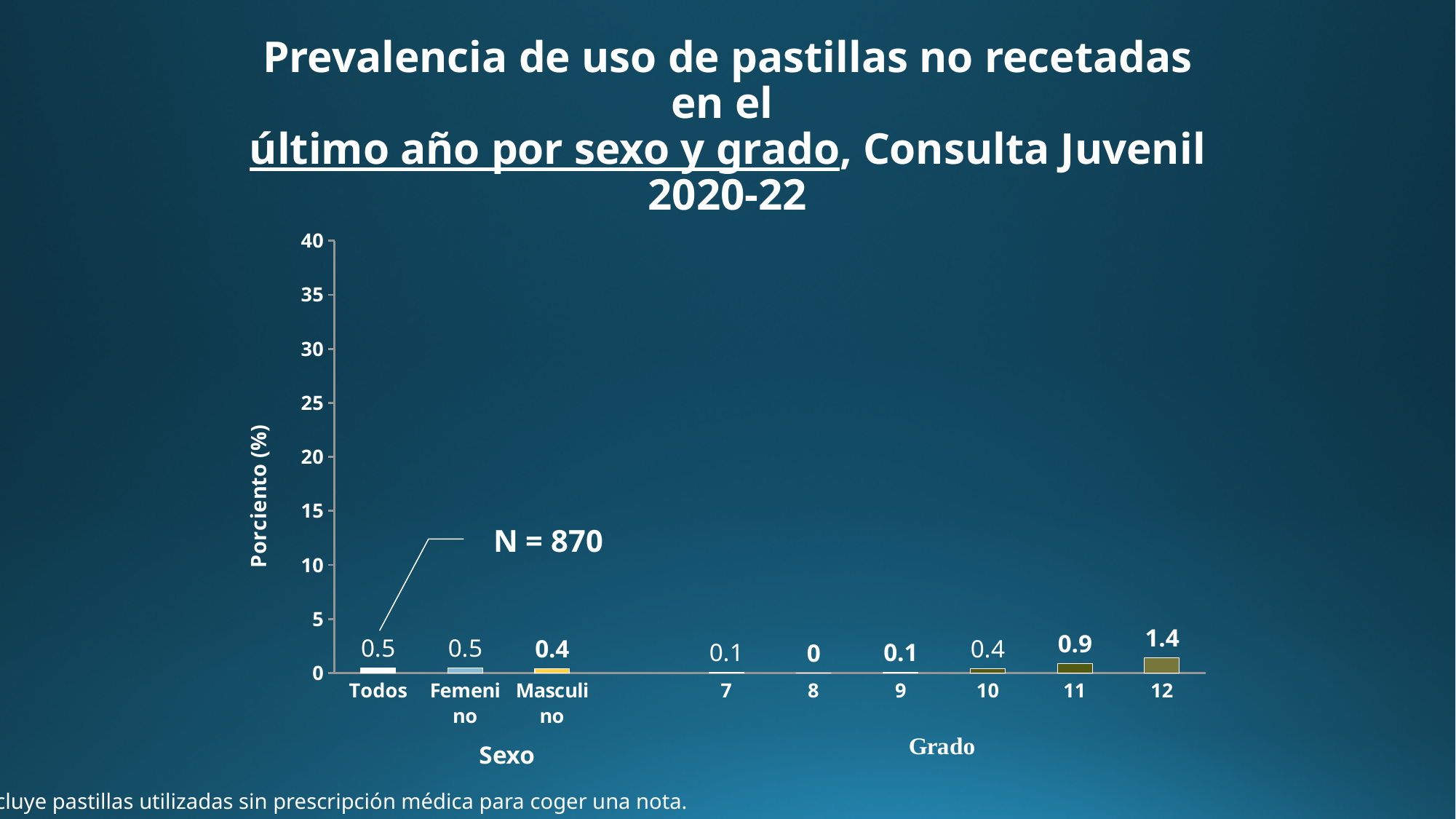
What is the sample size (N) shown on the chart? N = 870 What kind of chart is shown? bar chart What is the value for Masculino? 0.4 What is the value for Todos? 0.5 What is the difference between the values for grade 12 and grade 11? 0.5 Which is larger, the value for Femenino or for Masculino? Femenino Which grade has the lowest value? 8 Which grade has the highest value? 12 What is the value for grade 8? 0 Is the value for grade 12 greater or less than 5? less How many categories are plotted on the chart? 9 What is the value for grade 12? 1.4